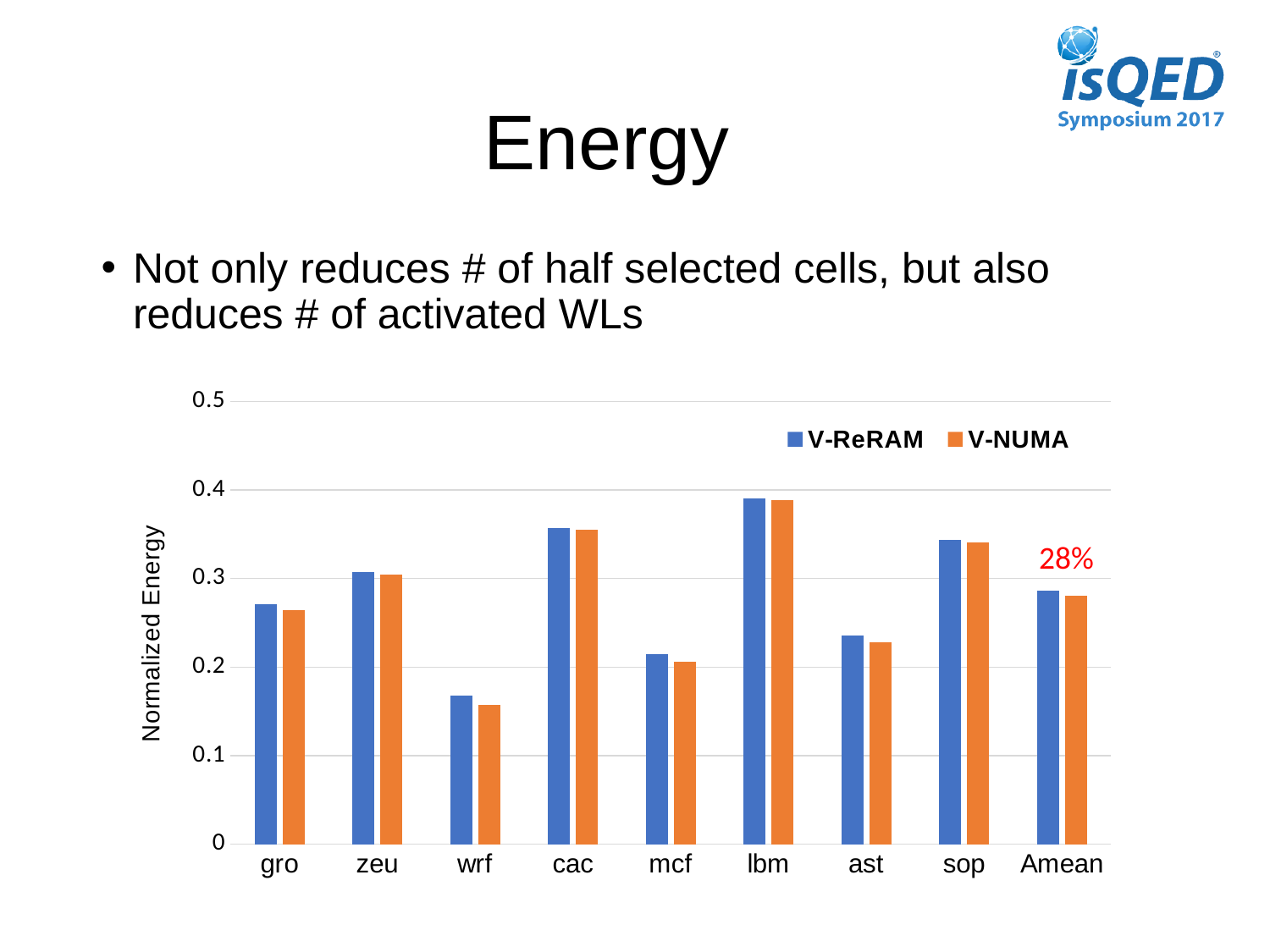
Is the V-NUMA value for cac greater or less than 0.3? greater Is the V-ReRAM value for mcf greater or less than 0.3? less How many series does the legend list? 2 Is the V-NUMA value for lbm greater or less than 0.3? greater What kind of chart is shown on the slide? bar chart How many categories are shown on the x axis? 9 What percentage is annotated in red above the Amean bars? 28% What is the label of the y axis? Normalized Energy Which category has the highest V-ReRAM value? lbm Which category has the lowest V-NUMA value? wrf Which has the larger V-ReRAM value, cac or mcf? cac